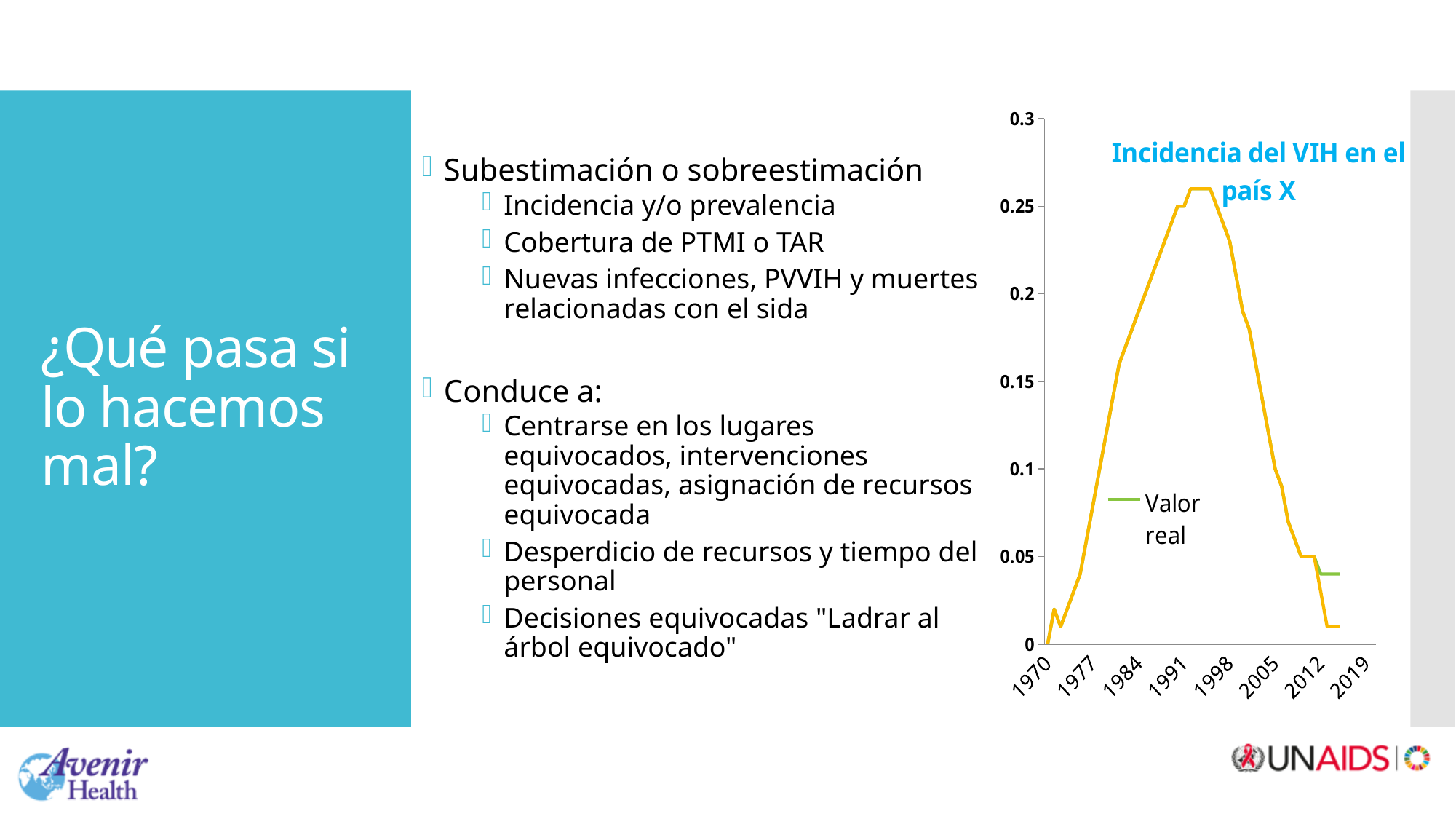
Which is larger, the value of the yellow line in 1991 or in 2012? 1991 Is the value of the yellow line in 2005 greater or less than 0.15? less Is the value of the yellow line in 1984 greater or less than 0.15? greater What is the highest value shown on the y axis? 0.3 What kind of chart is shown on the slide? line chart Is the value of the yellow line in 1970 greater or less than 0.05? less What is the title of the chart? Incidencia del VIH en el país X Does the yellow line rise or fall between 1977 and 1991? rise Does the yellow line rise or fall between 1998 and 2012? fall What series name appears in the chart's legend? Valor real